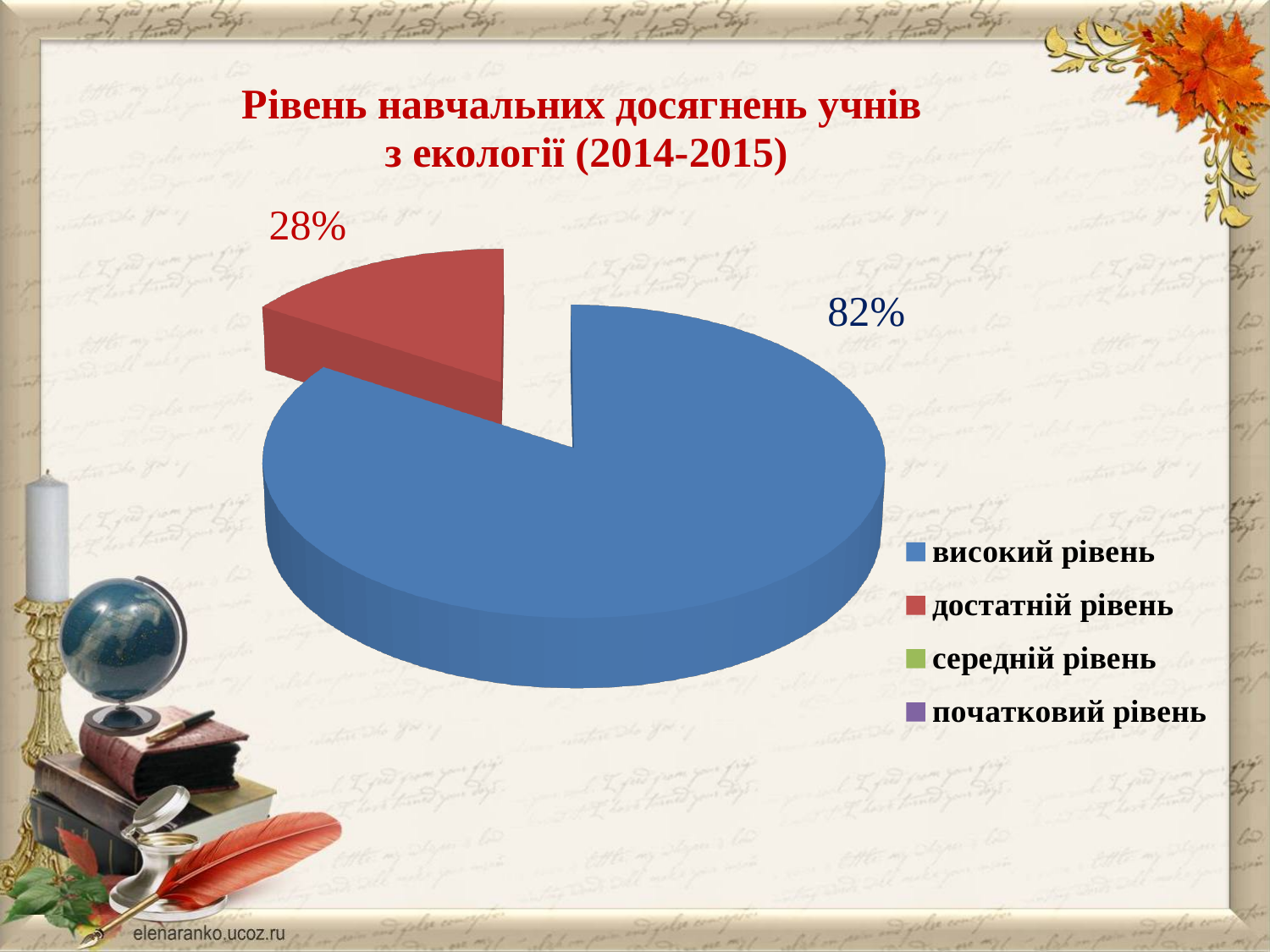
What kind of chart is shown on the slide? pie chart How many slices are visible in the pie? 2 What percentage is shown for високий рівень? 82% What years are given in the chart title? 2014-2015 What colour is the slice for достатній рівень? red How many entries does the legend list? 4 What is the difference in percentage points between the високий рівень slice and the достатній рівень slice? 54 Which category has the largest slice of the pie? високий рівень Which is larger, the slice for високий рівень or the slice for достатній рівень? високий рівень What percentage is shown for достатній рівень? 28%